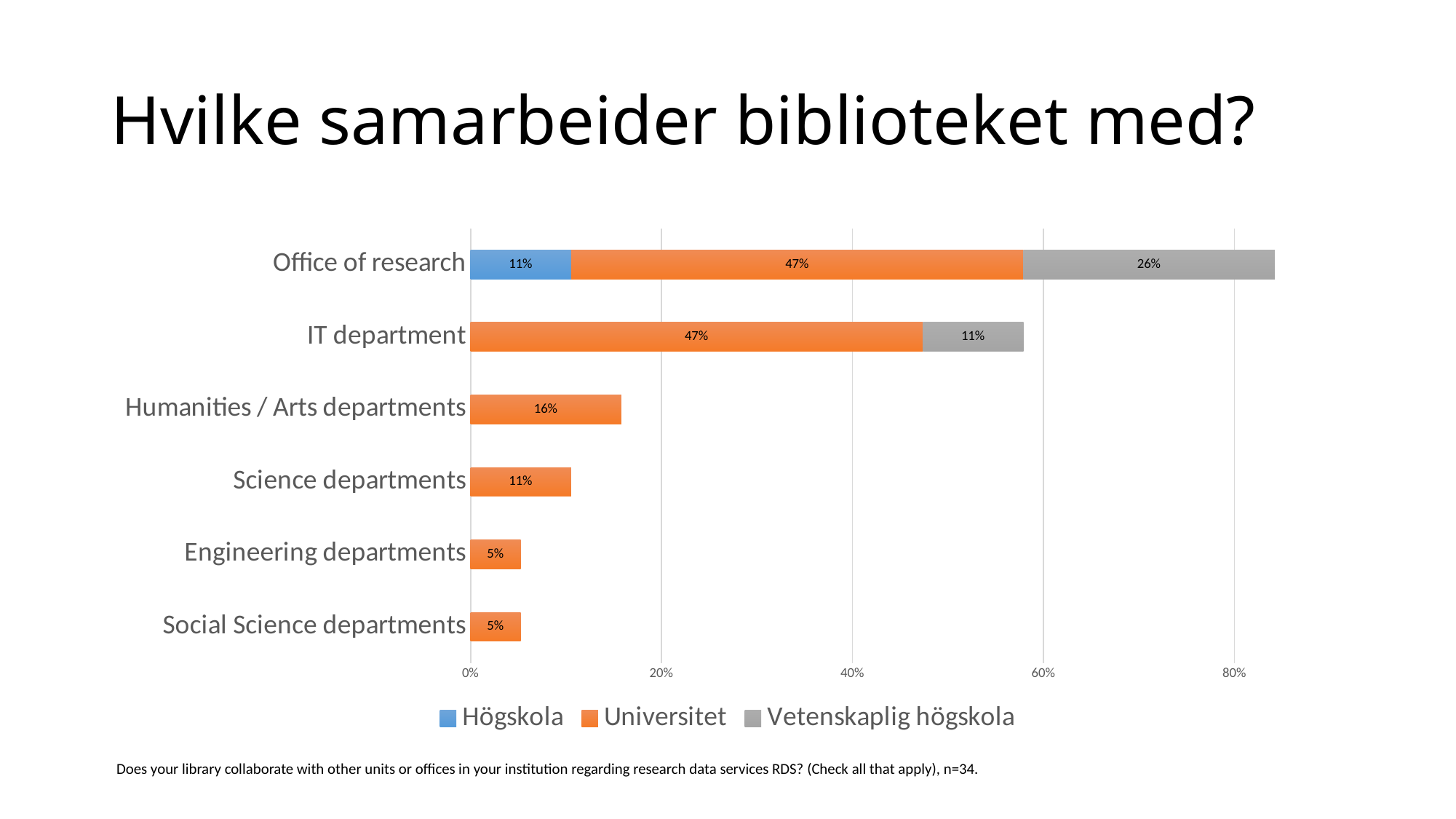
What kind of chart is shown on the slide? Stacked bar chart What is the Universitet value for Humanities / Arts departments? 16% What is the Vetenskaplig högskola value for IT department? 11% How many categories are shown on the chart? 6 How many series does the legend list? 3 What is the Högskola value for Office of research? 11% What is the total of the stacked bar for Office of research? 84% What is the difference between the Universitet value for Humanities / Arts departments and the Universitet value for Science departments? 5% What is the Universitet value for Office of research? 47% What is the Vetenskaplig högskola value for Office of research? 26% What is the total of the stacked bar for IT department? 58% Which category has the longest total bar? Office of research